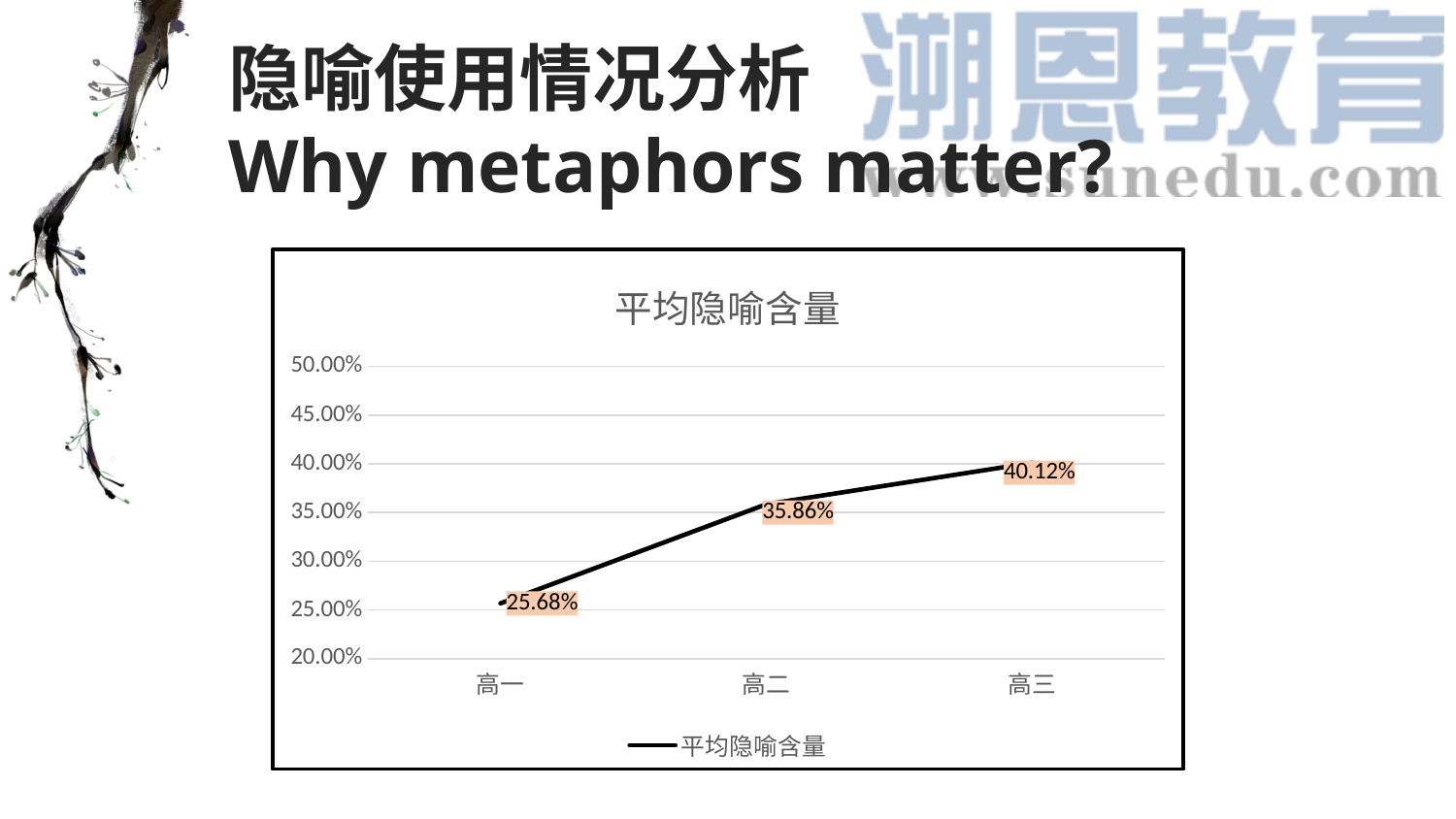
How many categories are plotted on the x axis? 3 Do the values rise or fall from 高一 to 高三? rise Which grade has the lowest 平均隐喻含量? 高一 What kind of chart is shown on the slide? line chart What is the difference between the values for 高二 and 高一? 10.18% What is the value for 高一 in the 平均隐喻含量 chart? 25.68% Is the value for 高一 greater or less than 30.00%? less Which is larger, the value for 高二 or the value for 高三? 高三 What is the value for 高三 in the 平均隐喻含量 chart? 40.12% What is the difference between the values for 高三 and 高一? 14.44% What is the value for 高二 in the 平均隐喻含量 chart? 35.86% Which grade has the highest 平均隐喻含量? 高三